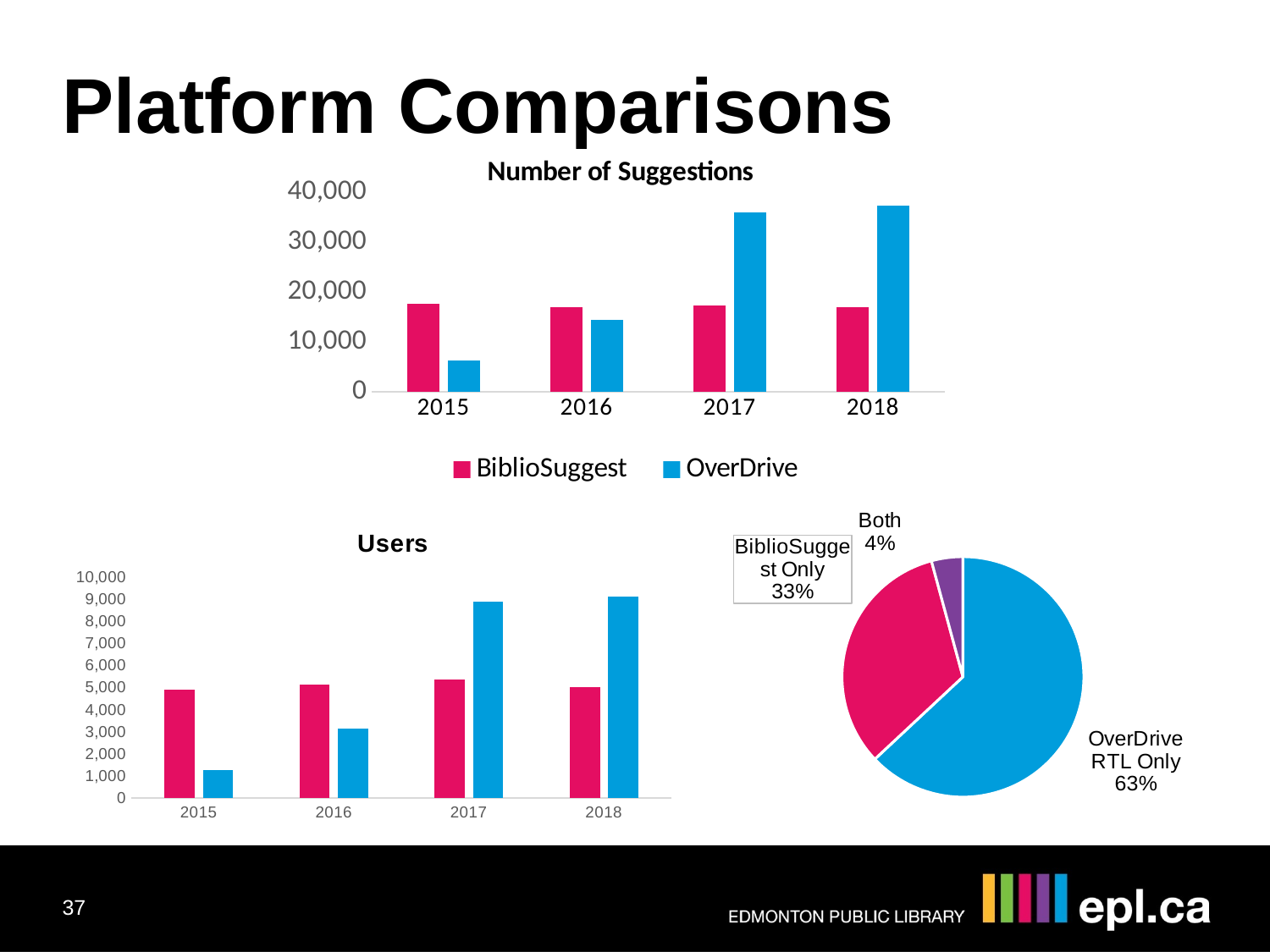
How many series does the legend of the Number of Suggestions chart list? 2 In the pie chart on the bottom right, what share is OverDrive RTL Only? 63% In the Number of Suggestions chart, do the OverDrive values rise or fall from 2015 to 2018? rise In the Number of Suggestions chart, which series has the larger value in 2018, BiblioSuggest or OverDrive? OverDrive In the Users chart, which series has the larger value in 2016, BiblioSuggest or OverDrive? BiblioSuggest In the Number of Suggestions chart, in which year is the OverDrive value lowest? 2015 In the Users chart, is the OverDrive value for 2015 greater or less than 2,000? less In the Number of Suggestions chart, is the OverDrive value for 2015 greater or less than 10,000? less In the Users chart, is the OverDrive value for 2017 greater or less than 8,000? greater In the Number of Suggestions chart, which series has the larger value in 2015, BiblioSuggest or OverDrive? BiblioSuggest How many years are shown on the x axis of the Users chart? 4